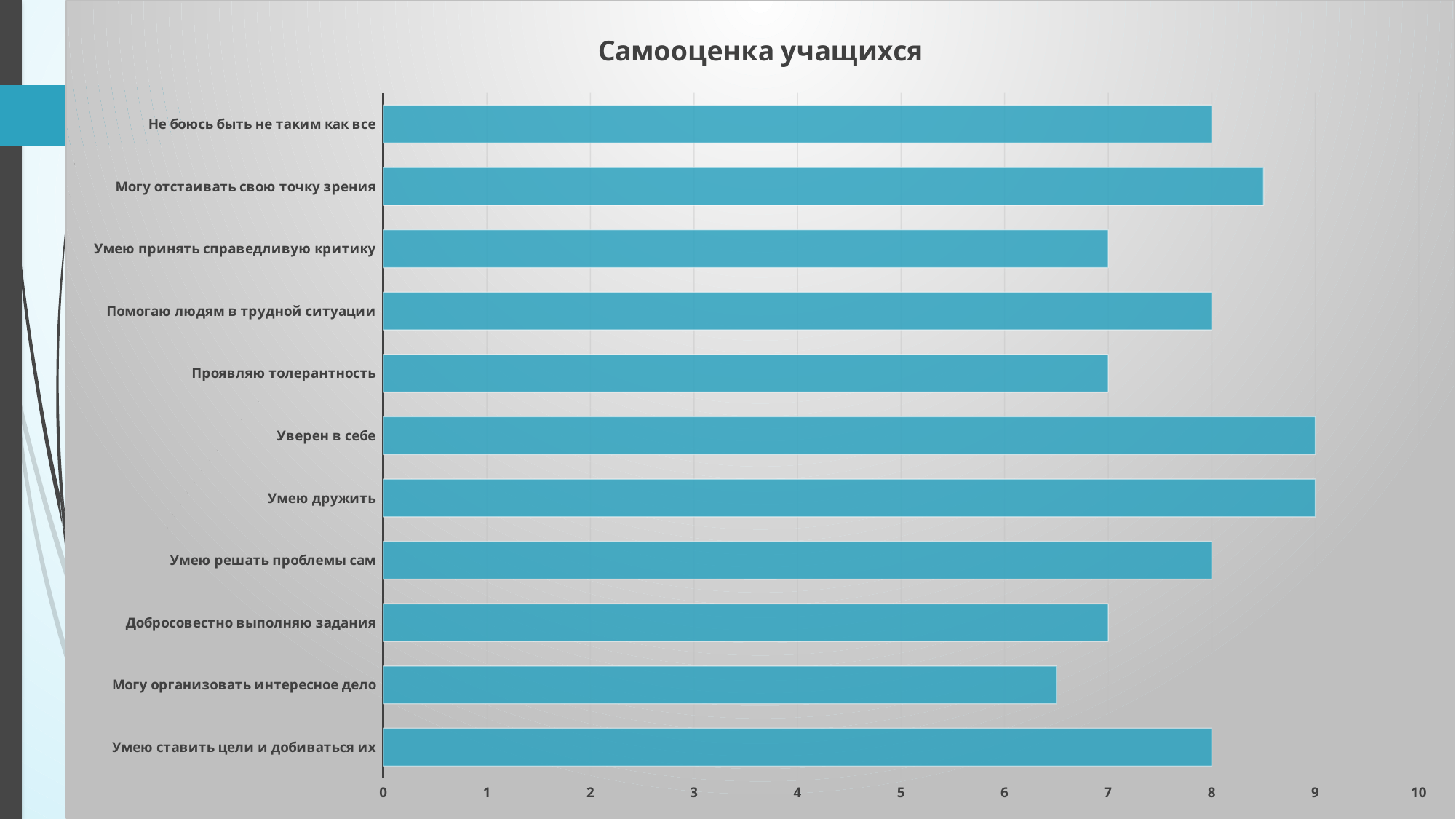
What is the value for "Умею принять справедливую критику"? 7 What is the title of the chart? Самооценка учащихся How many categories are plotted in the chart? 11 Which is larger: the value for "Умею решать проблемы сам" or the value for "Добросовестно выполняю задания"? Умею решать проблемы сам What is the difference between the values for "Уверен в себе" and "Проявляю толерантность"? 2 What is the value for "Умею ставить цели и добиваться их"? 8 Is the value for "Могу организовать интересное дело" greater or less than 7? less What type of chart is shown on the slide? bar chart Which category has the lowest value? Могу организовать интересное дело Is the value for "Могу отстаивать свою точку зрения" greater or less than 8? greater What is the value for "Уверен в себе"? 9 What is the value for "Умею дружить"? 9